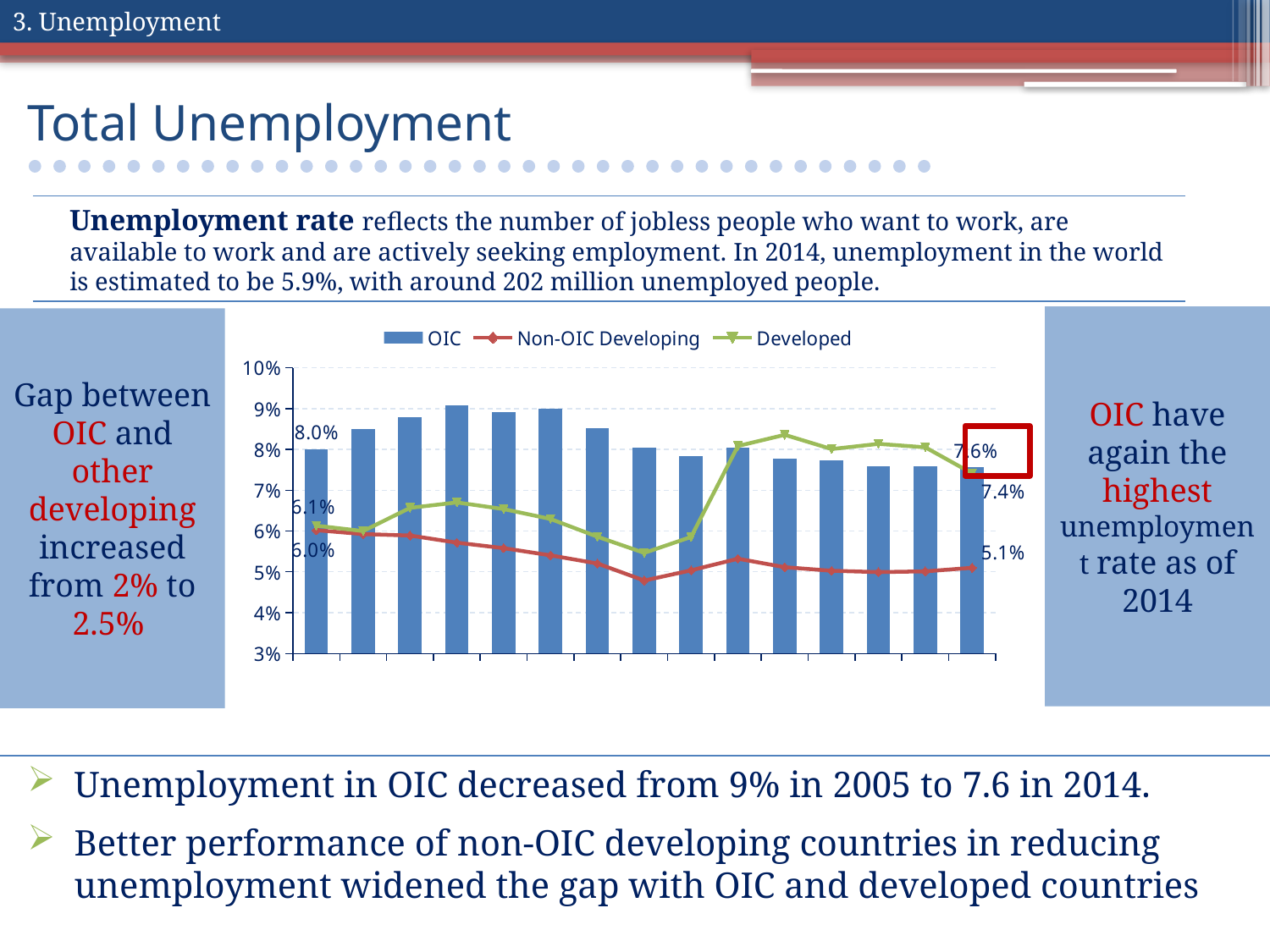
How many OIC bars are plotted in the chart? 15 What is the data label on the first OIC bar in the chart? 8.0% What is the labelled value of the first point on the Developed line? 6.1% What is the labelled value of the last point on the Developed line? 7.4% What is the data label on the last OIC bar in the chart? 7.6% At the last point in the chart, which is larger: the OIC value or the Developed value? OIC Is the highest point on the Developed line greater or less than 8%? greater What kind of chart is shown on the slide? Bar and line chart How many series does the chart legend list? 3 What is the difference between the last OIC value (7.6%) and the last Non-OIC Developing value (5.1%)? 2.5% What is the labelled value of the last point on the Non-OIC Developing line? 5.1% Which colour represents the OIC series in the chart legend? Blue